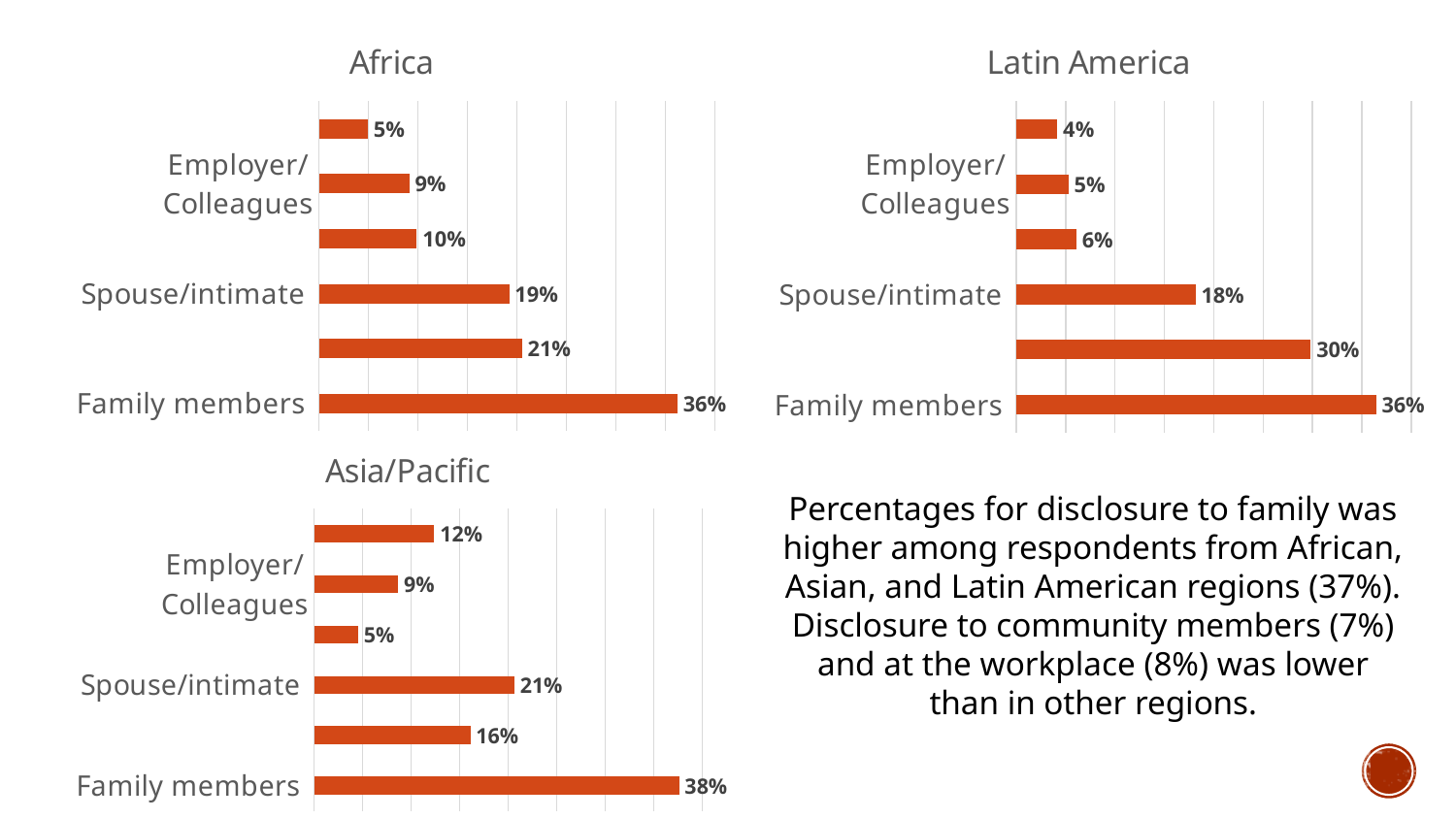
In the Latin America chart, which category has the highest value? Family members In the Asia/Pacific chart, which is larger, the value for Family members or the value for Spouse/intimate? Family members In the Africa chart, what is the difference between the values for Family members and Spouse/intimate? 17% What kind of chart is the Latin America chart? Bar chart In the Asia/Pacific chart, what is the value for Spouse/intimate? 21% In the Asia/Pacific chart, what is the value for Family members? 38% In the Africa chart, what is the value for Family members? 36% In the Latin America chart, what is the value for Spouse/intimate? 18% In the Africa chart, what is the value for Spouse/intimate? 19% What is the title of the chart in the bottom-left of the slide? Asia/Pacific How many bars are plotted in the Africa chart? 6 In the Latin America chart, what is the difference between the values for Family members and Spouse/intimate? 18%